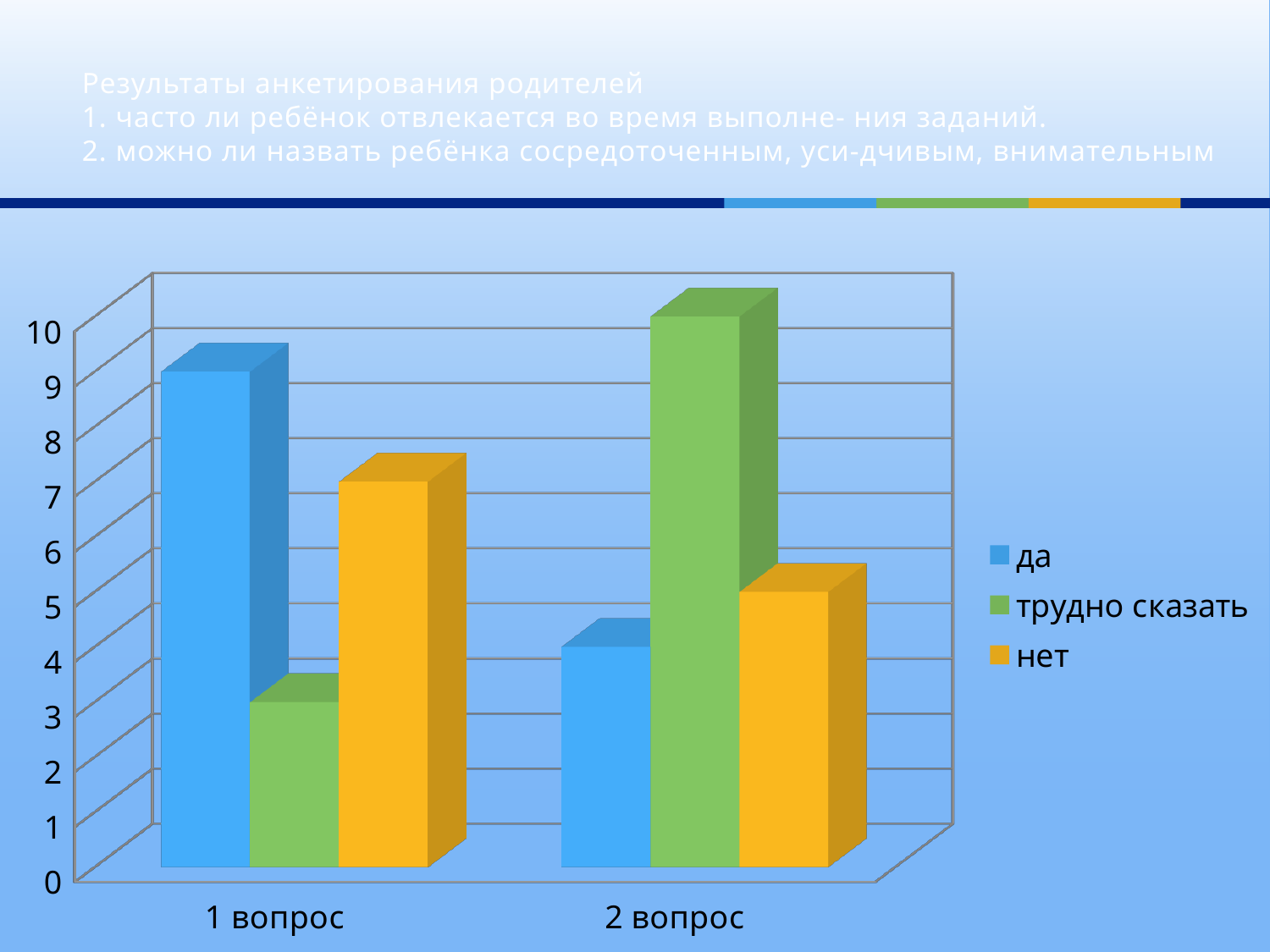
Which legend entry is shown in yellow? нет For 2 вопрос, which series has the highest value? трудно сказать Is the value for да in 1 вопрос greater or less than 7? greater What kind of chart is shown on the slide? bar chart How many series does the legend list? 3 Which is larger: the value for да in 1 вопрос or the value for да in 2 вопрос? 1 вопрос Which legend entry is shown in green? трудно сказать For 1 вопрос, which series has the highest value? да For 1 вопрос, which series has the lowest value? трудно сказать How many categories are shown on the x axis? 2 Is the value for трудно сказать in 2 вопрос greater or less than 8? greater Is the value for трудно сказать in 1 вопрос greater or less than 5? less